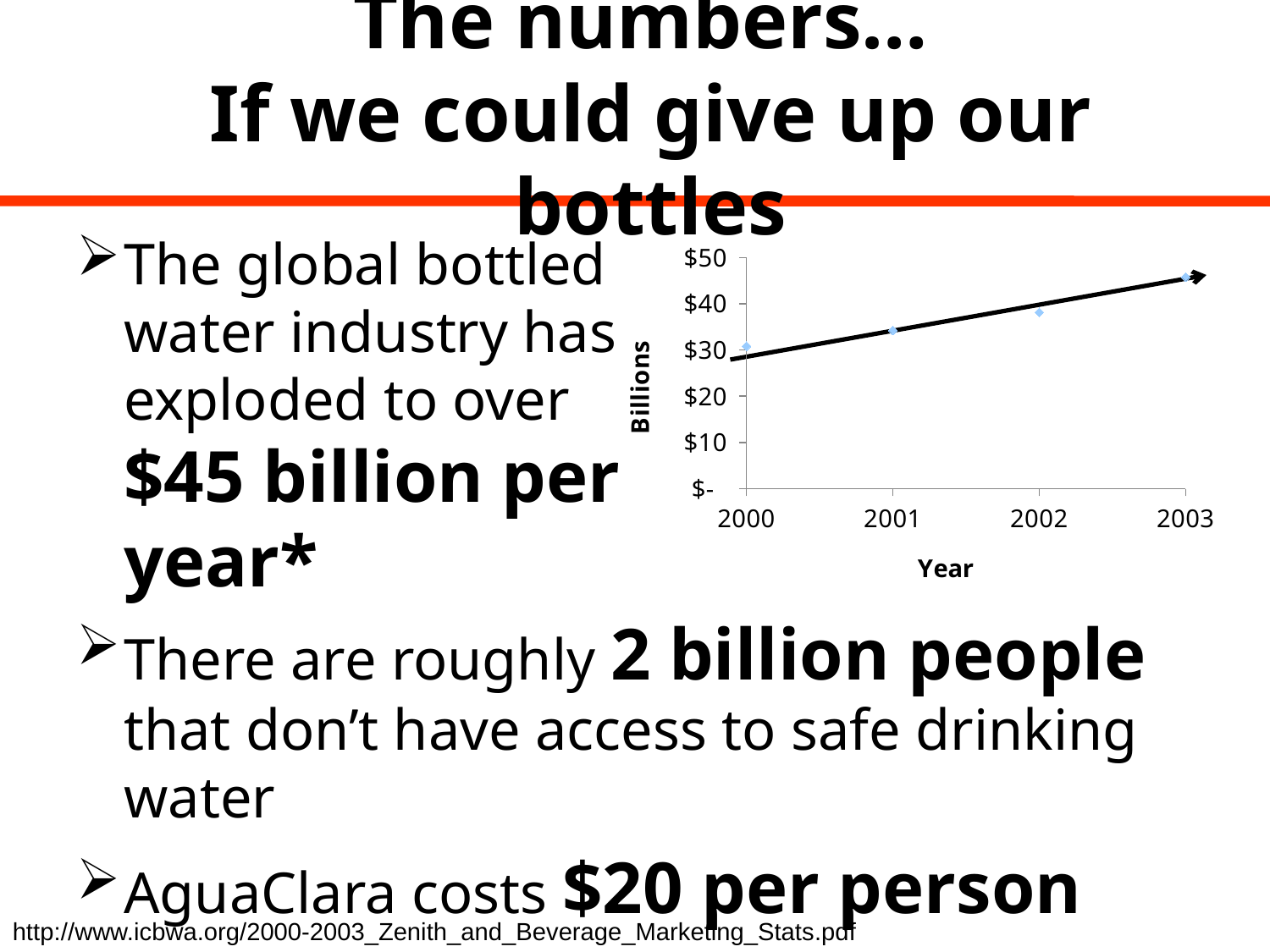
Is the value for 2001 greater or less than $30? greater Which year has the lowest value in the chart? 2000 Do the values in the chart rise or fall from 2000 to 2003? rise Is the value for 2002 greater or less than $30? greater What is the label of the y axis of the chart? Billions How many years are plotted on the x axis of the chart? 4 Which year has the highest value in the chart? 2003 Which year has the larger value, 2001 or 2003? 2003 What kind of chart is shown on the slide? scatter chart Is the value for 2003 greater or less than $40? greater What is the label of the x axis of the chart? Year